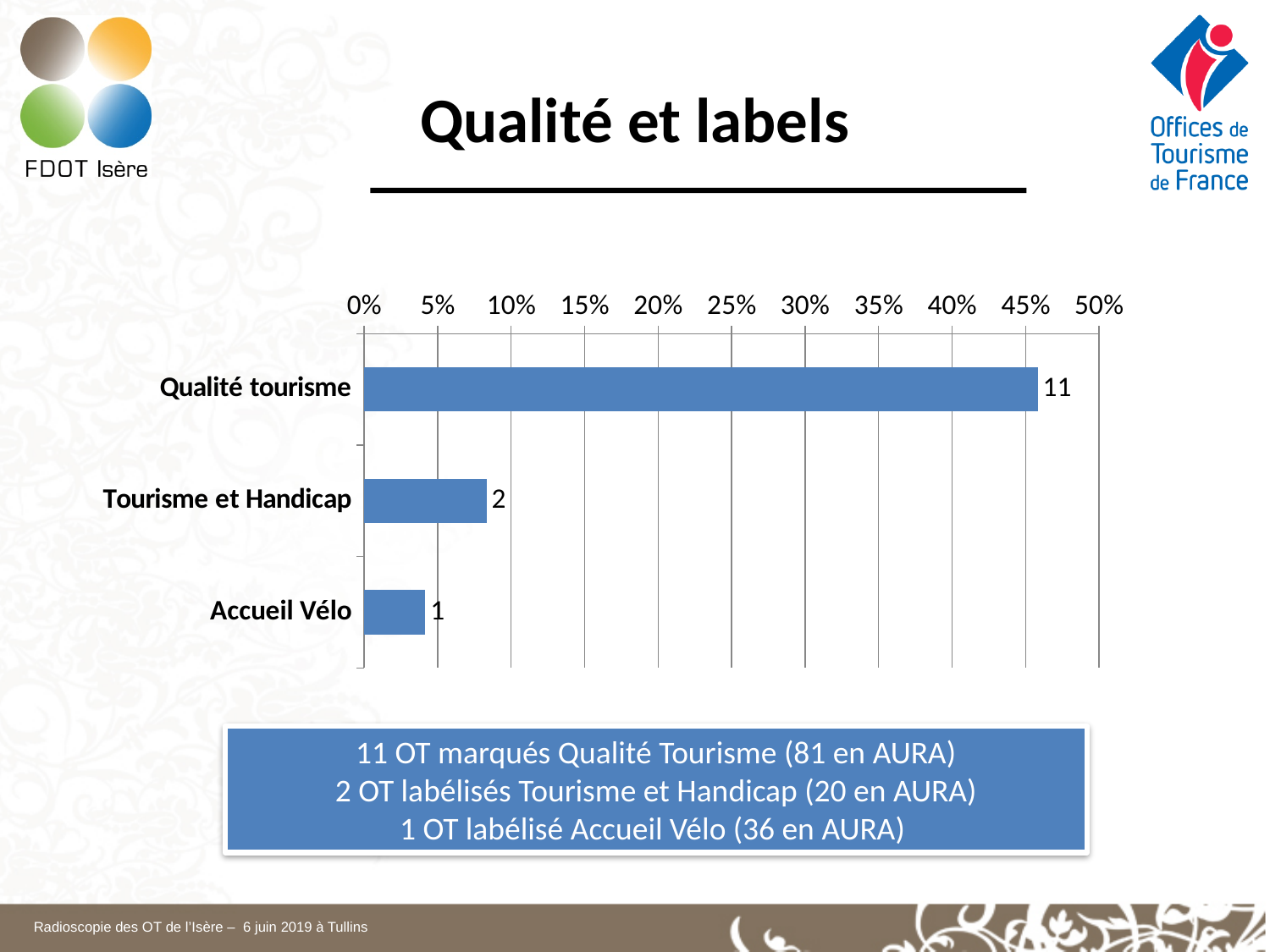
What is the difference between the data labels for Qualité tourisme and Tourisme et Handicap? 9 Which category has the longest bar? Qualité tourisme Is the bar for Qualité tourisme greater or less than 40% on the axis? greater What data label is shown on the bar for Accueil Vélo? 1 Which is larger, the value for Tourisme et Handicap or the value for Accueil Vélo? Tourisme et Handicap Is the bar for Tourisme et Handicap greater or less than 5% on the axis? greater How many categories are shown in the chart? 3 What data label is shown on the bar for Tourisme et Handicap? 2 Which category has the shortest bar? Accueil Vélo What data label is shown on the bar for Qualité tourisme? 11 Is the bar for Accueil Vélo greater or less than 5% on the axis? less What kind of chart is shown on the slide? Bar chart